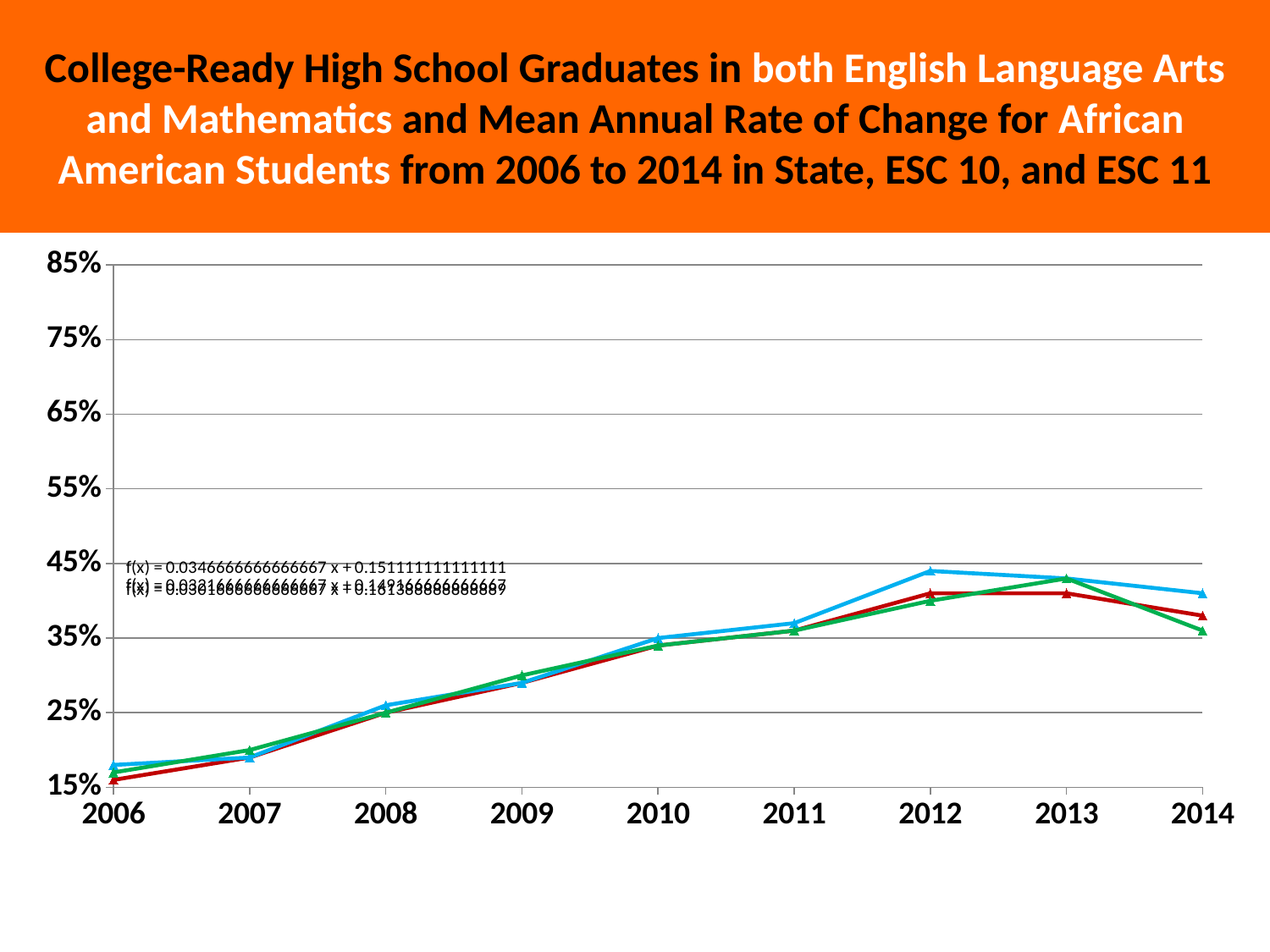
In which year do all three lines reach their lowest value? 2006 In which year does the green line reach its highest value? 2013 How many lines are plotted on the chart? 3 Does the green line rise or fall from 2013 to 2014? fall Do the plotted values generally rise or fall from 2006 to 2012? rise What is the highest value shown on the y axis? 85% Is the value of the green line in 2009 greater or less than 35%? less Is the value of the blue line in 2013 greater or less than 45%? less What kind of chart is shown on the slide? line chart How many years are plotted along the x axis? 9 Is the value of the red line in 2006 greater or less than 25%? less